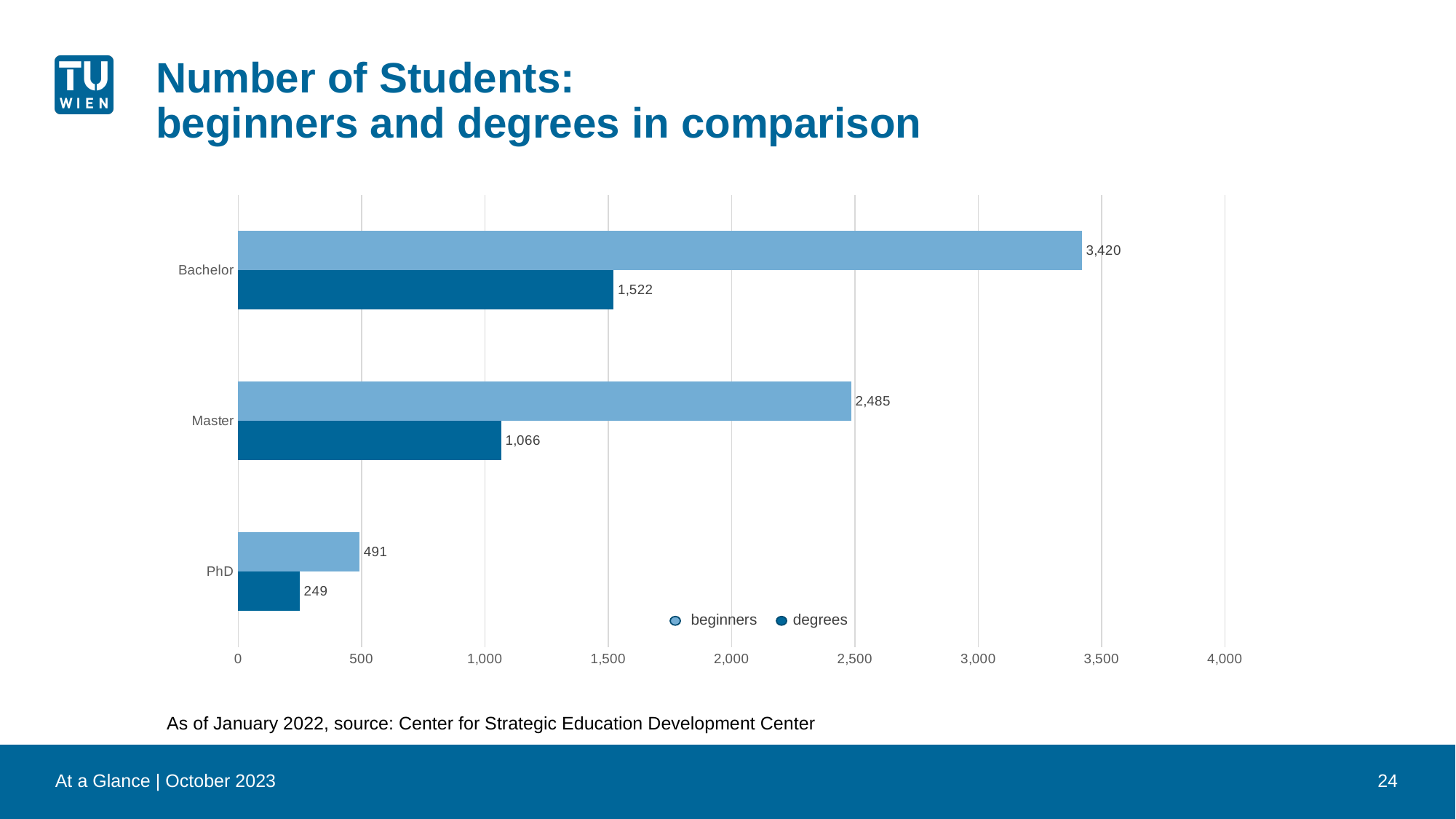
How many series does the legend list? 2 What is the difference between Master beginners and PhD beginners? 1,994 What kind of chart is shown on the slide? bar chart What is the difference between beginners and degrees for Bachelor? 1,898 What is the number of beginners for Bachelor? 3,420 What is the number of degrees for Master? 1,066 Which series is shown in the darker blue colour? degrees Which is larger: degrees for Bachelor or beginners for Master? beginners for Master Which category has the lowest number of degrees? PhD What is the number of degrees for PhD? 249 How many categories are shown on the chart? 3 Which category has the highest number of beginners? Bachelor